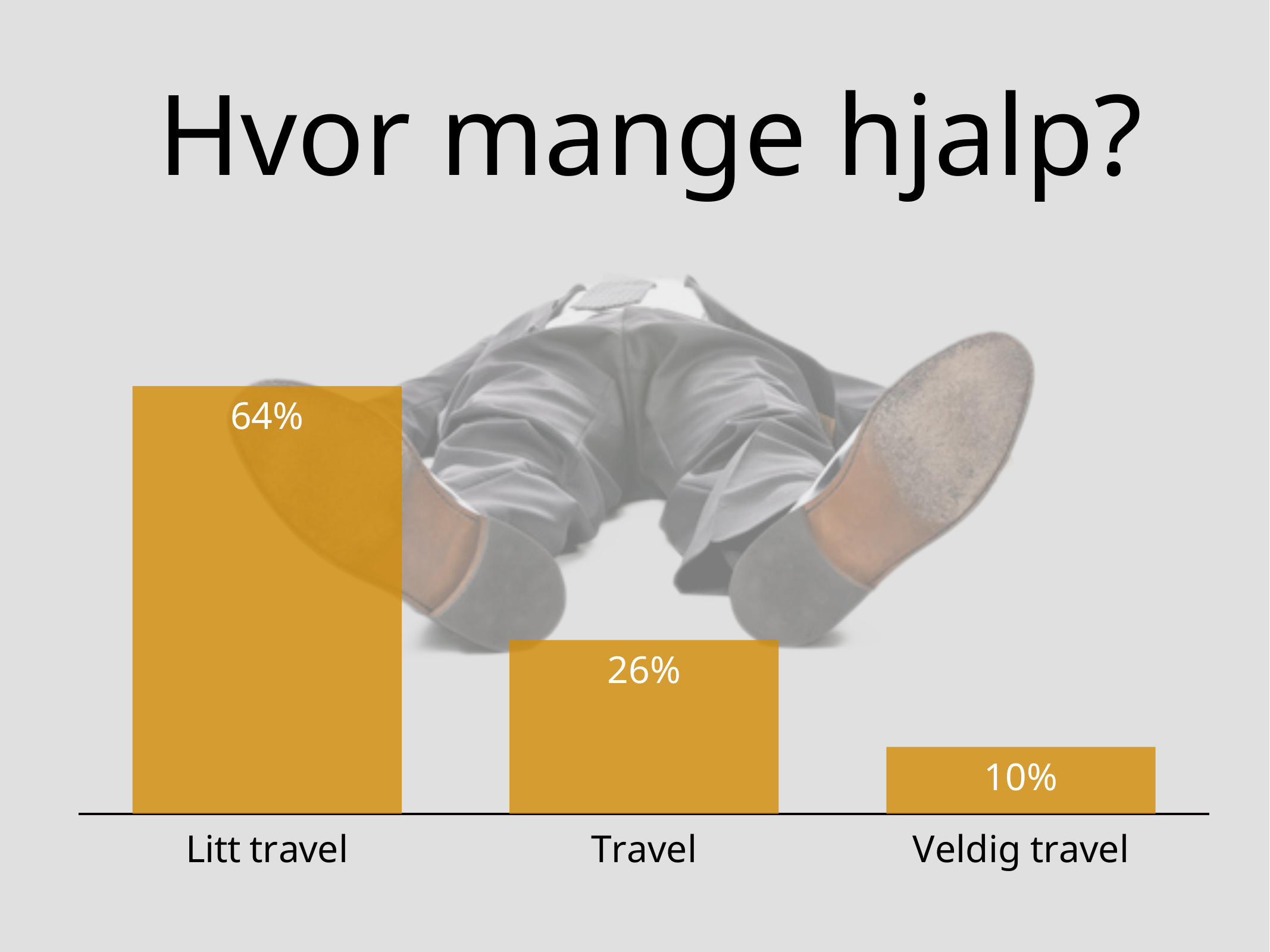
What is the difference between the values for Litt travel and Travel? 38% What is the value for Veldig travel? 10% What kind of chart is shown on the slide? Bar chart Which category has the highest value? Litt travel Do the values rise or fall from left to right across the categories? Fall What is the value for Travel? 26% What is the value for Litt travel? 64% What is the difference between the values for Travel and Veldig travel? 16% What is the title of the slide? Hvor mange hjalp? Which category has the lowest value? Veldig travel Which is larger, the value for Travel or the value for Veldig travel? Travel How many categories are shown in the chart? 3